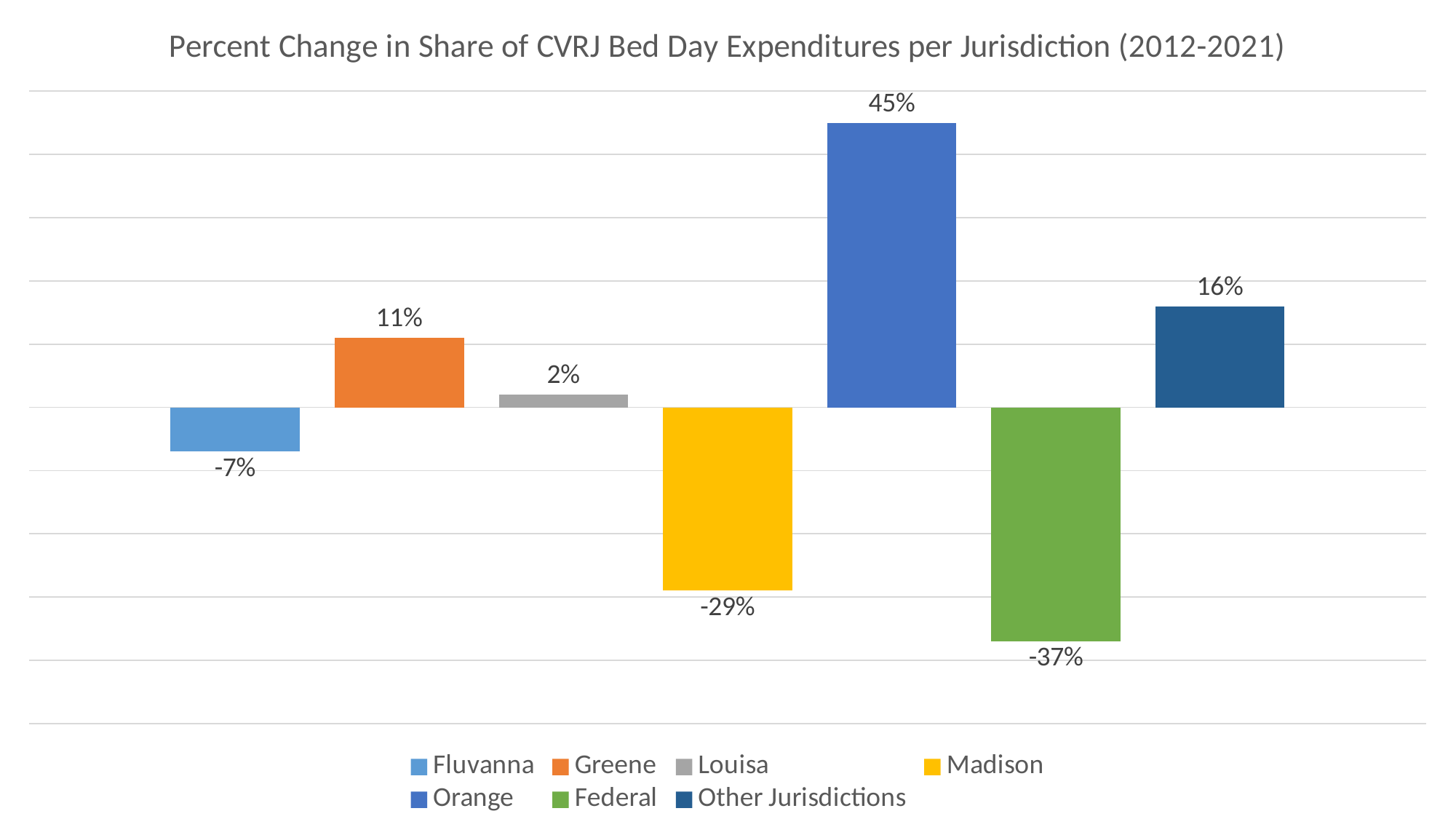
What type of chart is shown? Bar chart What is the percent change for Orange? 45% What is the percent change for Other Jurisdictions? 16% How many jurisdictions are shown in the chart? 7 Which has a larger percent change, Greene or Louisa? Greene Which jurisdiction has the lowest percent change? Federal How many entries does the legend list? 7 What colour is the bar for Madison? Yellow What is the percent change for Fluvanna? -7% What is the difference between the percent change for Orange and for Greene? 34 percentage points What is the percent change for Madison? -29% Which jurisdiction has the highest percent change? Orange